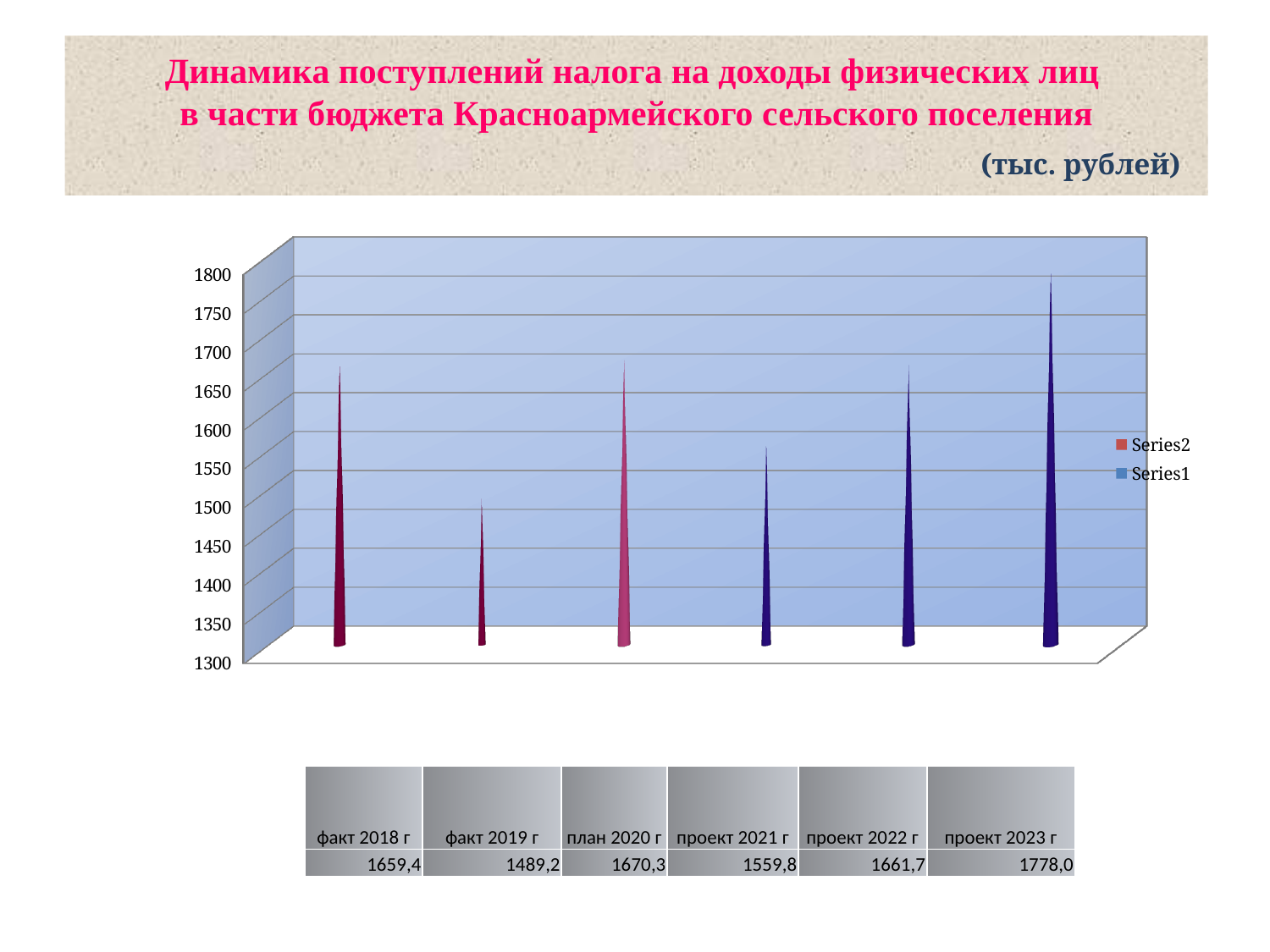
What unit is stated in the chart title? тыс. рублей Which category has the lowest value? факт 2019 г Which is larger, the value for факт 2018 г or the value for проект 2022 г? проект 2022 г What is the value for проект 2023 г? 1778,0 What is the value for план 2020 г? 1670,3 Is the value for проект 2021 г greater or less than 1600? less How many categories are shown on the x axis? 6 Which category has the highest value? проект 2023 г What is the difference between the values for план 2020 г and проект 2021 г? 110,5 What is the value for факт 2018 г? 1659,4 What is the difference between the values for проект 2023 г and факт 2019 г? 288,8 How many series does the legend list? 2